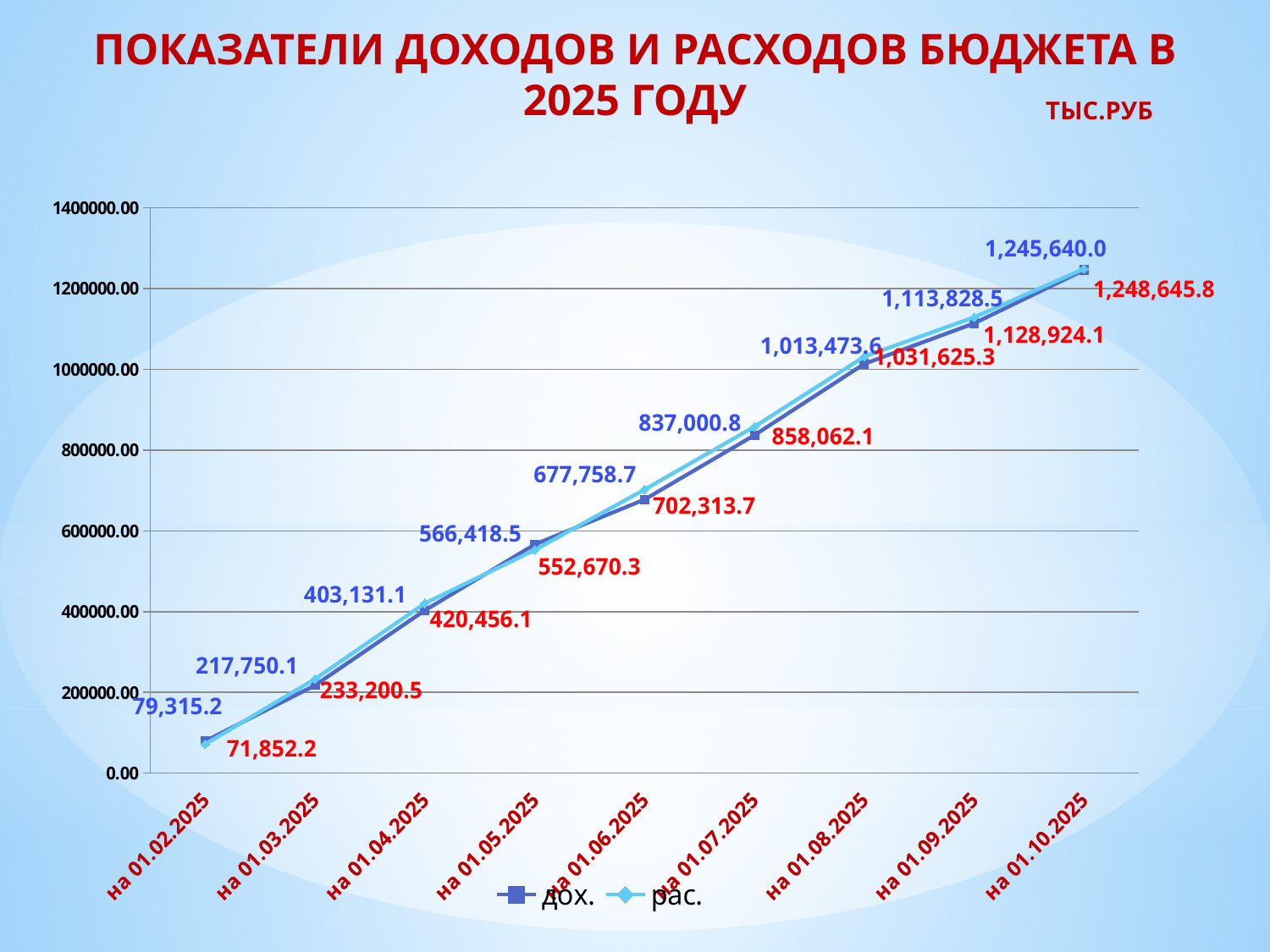
Do the values of дох. rise or fall from 01.02.2025 to 01.10.2025? rise What is the value of дох. on 01.05.2025? 566,418.5 What is the value of дох. on 01.02.2025? 79,315.2 On which date is the value of рас. lowest? на 01.02.2025 On which date is the value of дох. highest? на 01.10.2025 What is the difference between рас. and дох. on 01.07.2025? 21,061.3 How many series does the legend list? 2 Which is larger on 01.02.2025, дох. or рас.? дох. What is the value of рас. on 01.08.2025? 1,031,625.3 How many dates are plotted on the x axis? 9 What is the value of рас. on 01.10.2025? 1,248,645.8 What kind of chart is shown on the slide? line chart